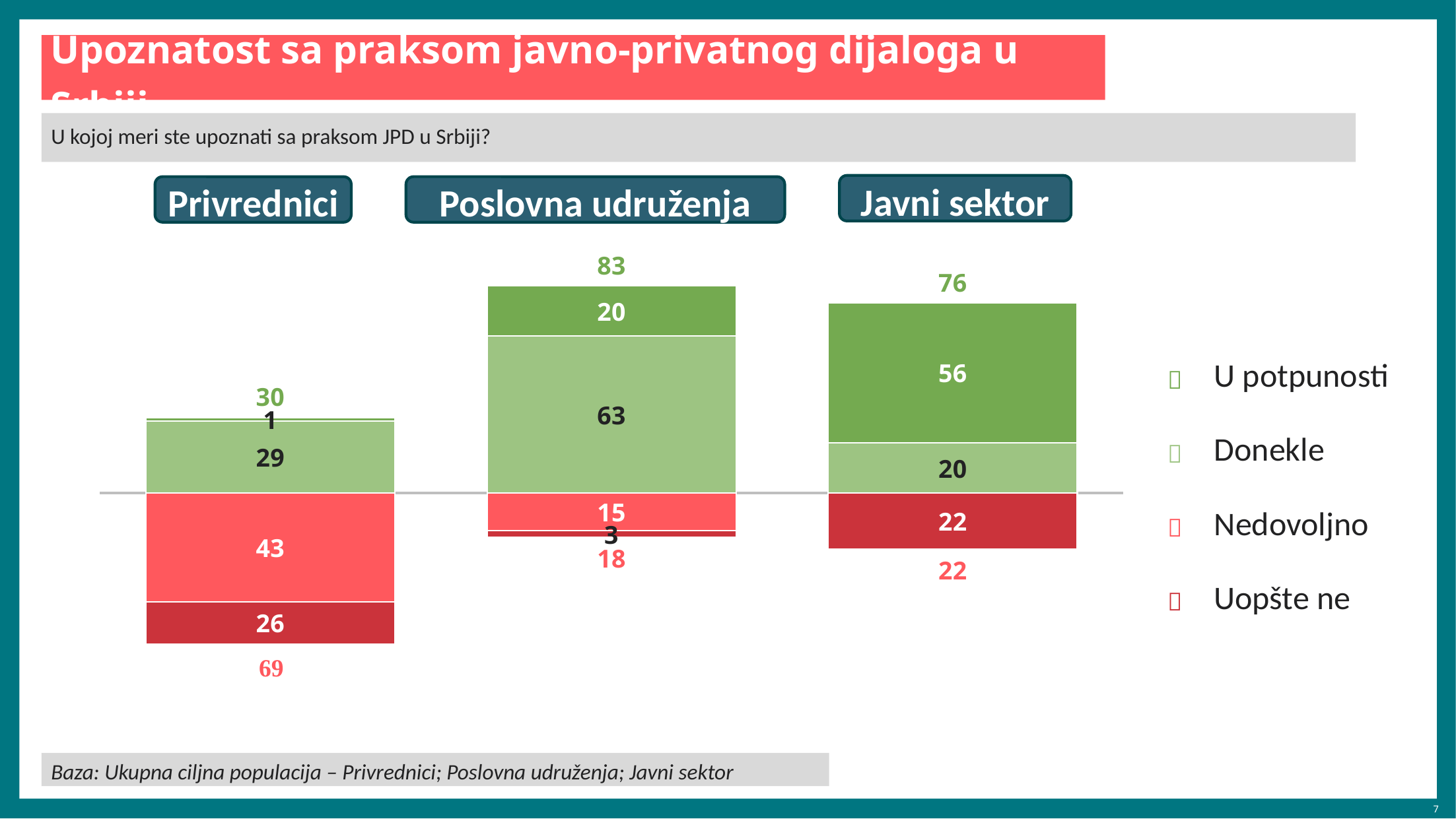
What is the combined positive total (U potpunosti + Donekle) shown above the bar for Poslovna udruženja? 83 What is the 'Uopšte ne' value for Poslovna udruženja? 3 What is the 'Donekle' value for Poslovna udruženja? 63 Which group has the lowest positive total (green total above the bar)? Privrednici What is the difference between the 'Donekle' values for Poslovna udruženja and Privrednici? 34 What is the 'Nedovoljno' value for Privrednici? 43 What kind of chart is shown on the slide? stacked bar chart What is the combined negative total shown below the bar for Privrednici? 69 Which group has the highest 'U potpunosti' value? Javni sektor What is the 'U potpunosti' value for Javni sektor? 56 How many groups (categories) are shown in the chart? 3 How many series does the legend list? 4